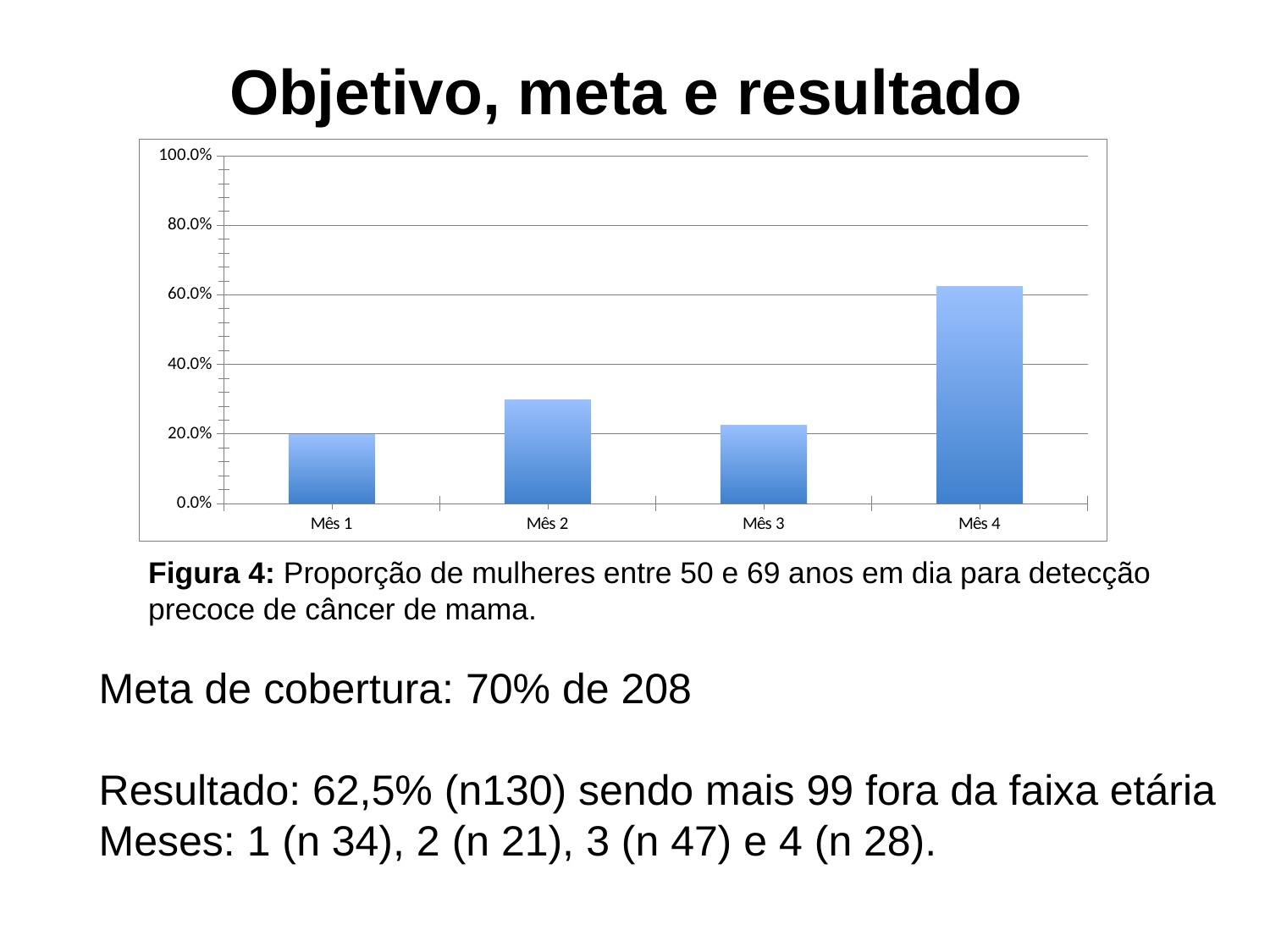
Is the value for Mês 1 greater or less than 40.0%? less How many categories (months) are plotted on the x axis? 4 Which is larger, the value for Mês 2 or the value for Mês 3? Mês 2 Which is larger, the value for Mês 4 or the value for Mês 2? Mês 4 Is the value for Mês 4 greater or less than 80.0%? less Is the value for Mês 3 greater or less than 40.0%? less Which month has the highest bar? Mês 4 What is the highest value shown on the y axis of the chart? 100.0% What figure number is given in the caption below the chart? Figura 4 What kind of chart is shown on the slide? bar chart